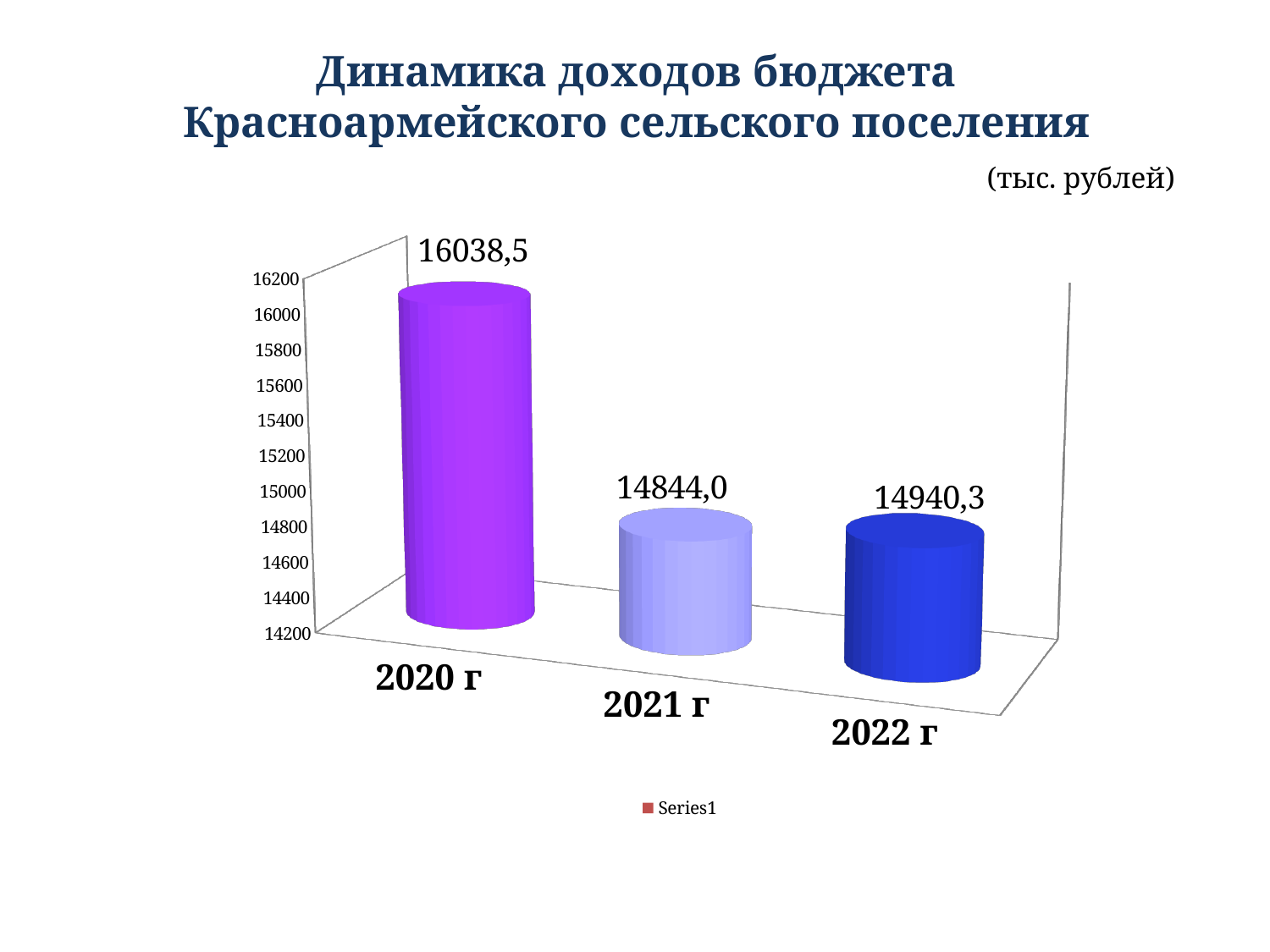
Which year has the highest budget income on the chart? 2020 г Which is larger, the value for 2021 г or the value for 2022 г? 2022 г What is the budget income value shown for 2021 г? 14844,0 Does the value fall or rise from 2020 г to 2021 г? Falls What kind of chart is shown on the slide? Bar chart What is the budget income value shown for 2022 г? 14940,3 What is the difference between the values for 2022 г and 2021 г? 96,3 What is the difference between the values for 2020 г and 2021 г? 1194,5 How many series does the legend list? 1 Which year has the lowest budget income on the chart? 2021 г How many years (categories) are shown on the chart? 3 What is the budget income value shown for 2020 г? 16038,5